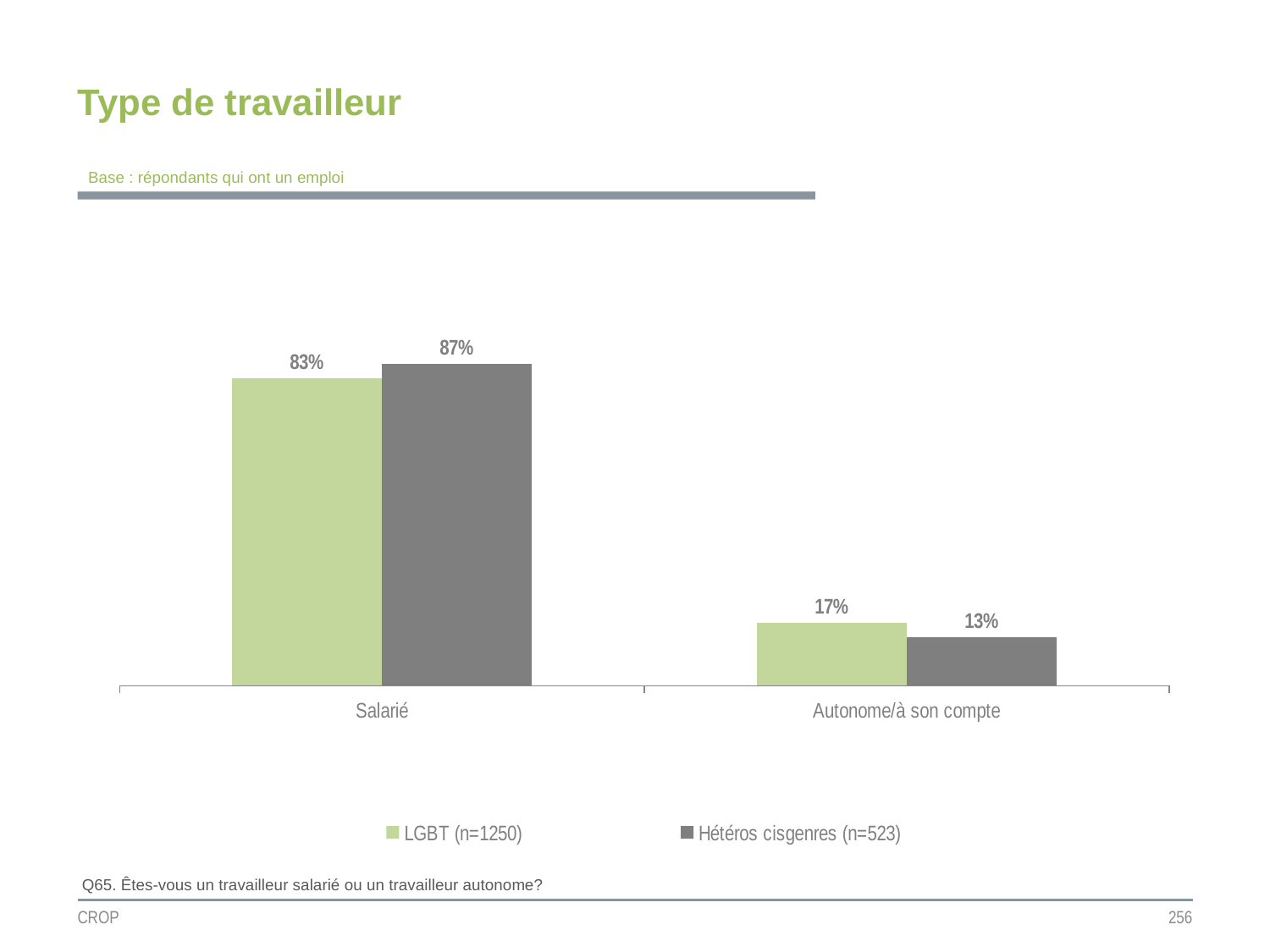
What kind of chart is shown on the slide? Bar chart Which category has the lowest value for the Hétéros cisgenres (n=523) series? Autonome/à son compte What is the value for LGBT (n=1250) in the Autonome/à son compte category? 17% What is the value for Hétéros cisgenres (n=523) in the Salarié category? 87% How many categories are shown on the x axis? 2 What is the value for Hétéros cisgenres (n=523) in the Autonome/à son compte category? 13% What is the value for LGBT (n=1250) in the Salarié category? 83% Which series has the larger value in the Autonome/à son compte category? LGBT (n=1250) What is the title of the chart on the slide? Type de travailleur How many series does the legend list? 2 Which category has the highest value for the LGBT (n=1250) series? Salarié What is the difference between the Hétéros cisgenres (n=523) and LGBT (n=1250) values for Salarié? 4%